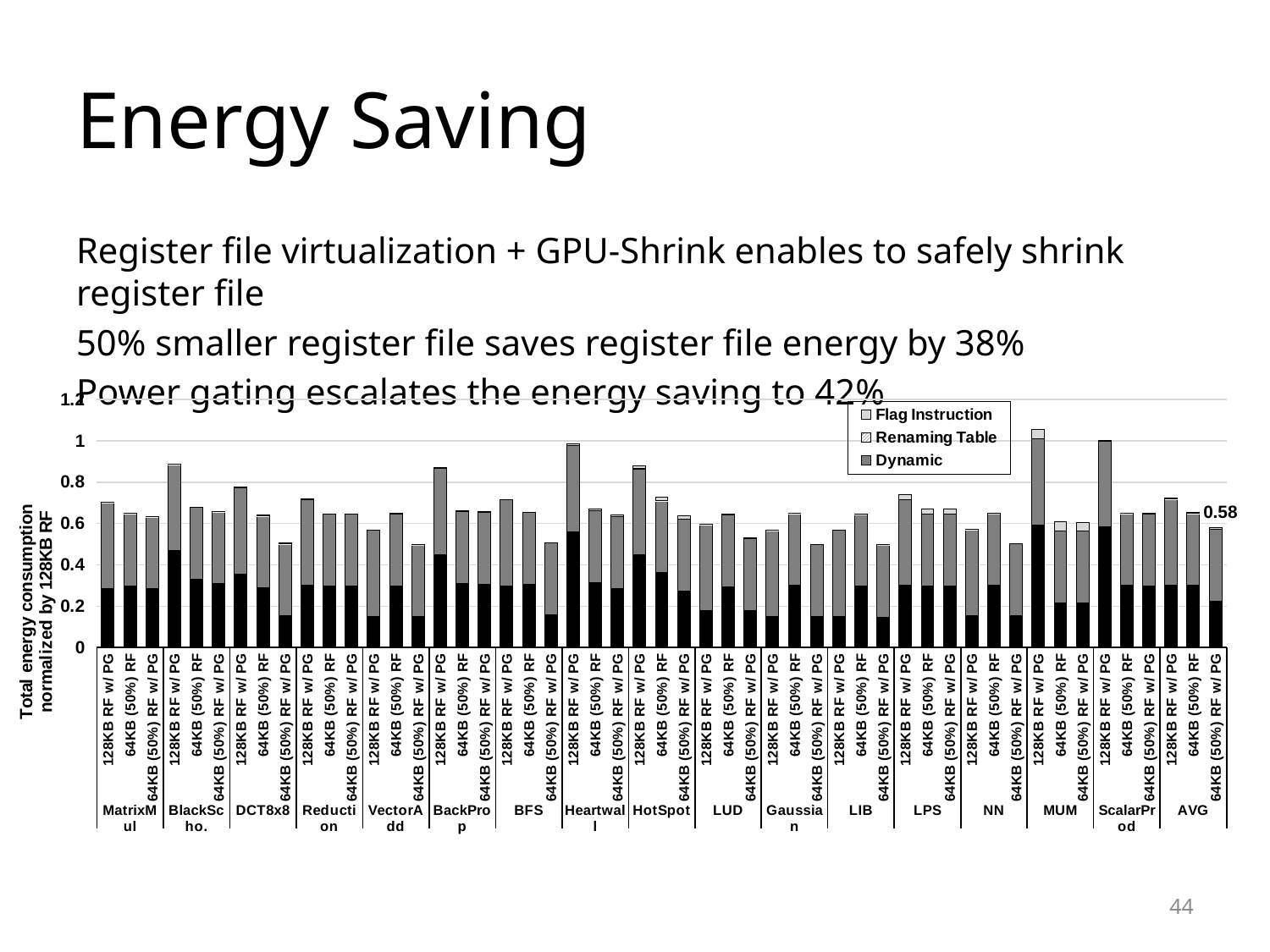
How many benchmark groups (including AVG) are shown along the x axis? 17 Which benchmark group contains the tallest bar in the chart? MUM What are the three series listed in the chart legend? Flag Instruction, Renaming Table, Dynamic In the AVG group, do the bar totals rise or fall going from 128KB RF w/ PG to 64KB (50%) RF w/ PG? fall What kind of chart is shown on the slide? Stacked bar chart Is the value for the LUD 64KB (50%) RF w/ PG bar greater or less than 0.6? less What is the total normalized energy consumption for the AVG 64KB (50%) RF w/ PG bar? 0.58 How many series does the chart legend list? 3 Within the MUM group, which bar is taller: 128KB RF w/ PG or 64KB (50%) RF? 128KB RF w/ PG Is the value for the VectorAdd 64KB (50%) RF w/ PG bar greater or less than 0.6? less Is the value for the MUM 128KB RF w/ PG bar greater or less than 1? greater